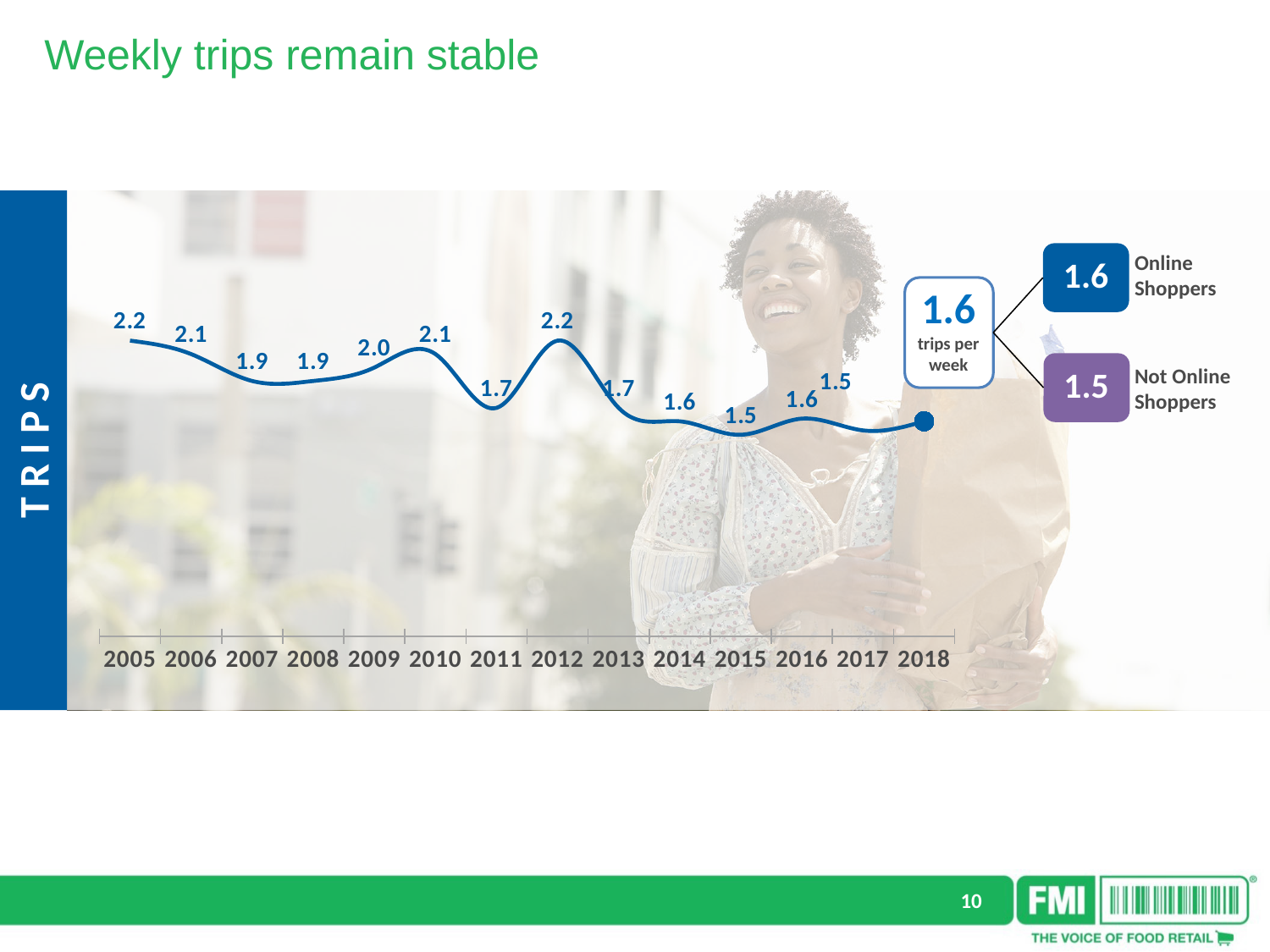
How many years are plotted on the x axis? 14 How many trips per week are shown for 2018? 1.6 What is the value for 2015? 1.5 What kind of chart is shown on the slide? line chart What is the value for 2012? 2.2 What is the title of the slide? Weekly trips remain stable Do the values generally rise or fall from 2005 to 2018? fall What is the difference between the values for 2005 and 2018? 0.6 Which is larger, the value for 2010 or the value for 2011? 2010 What is the value for 2005? 2.2 What is the value for 2009? 2.0 What is the trips-per-week value shown for Online Shoppers? 1.6